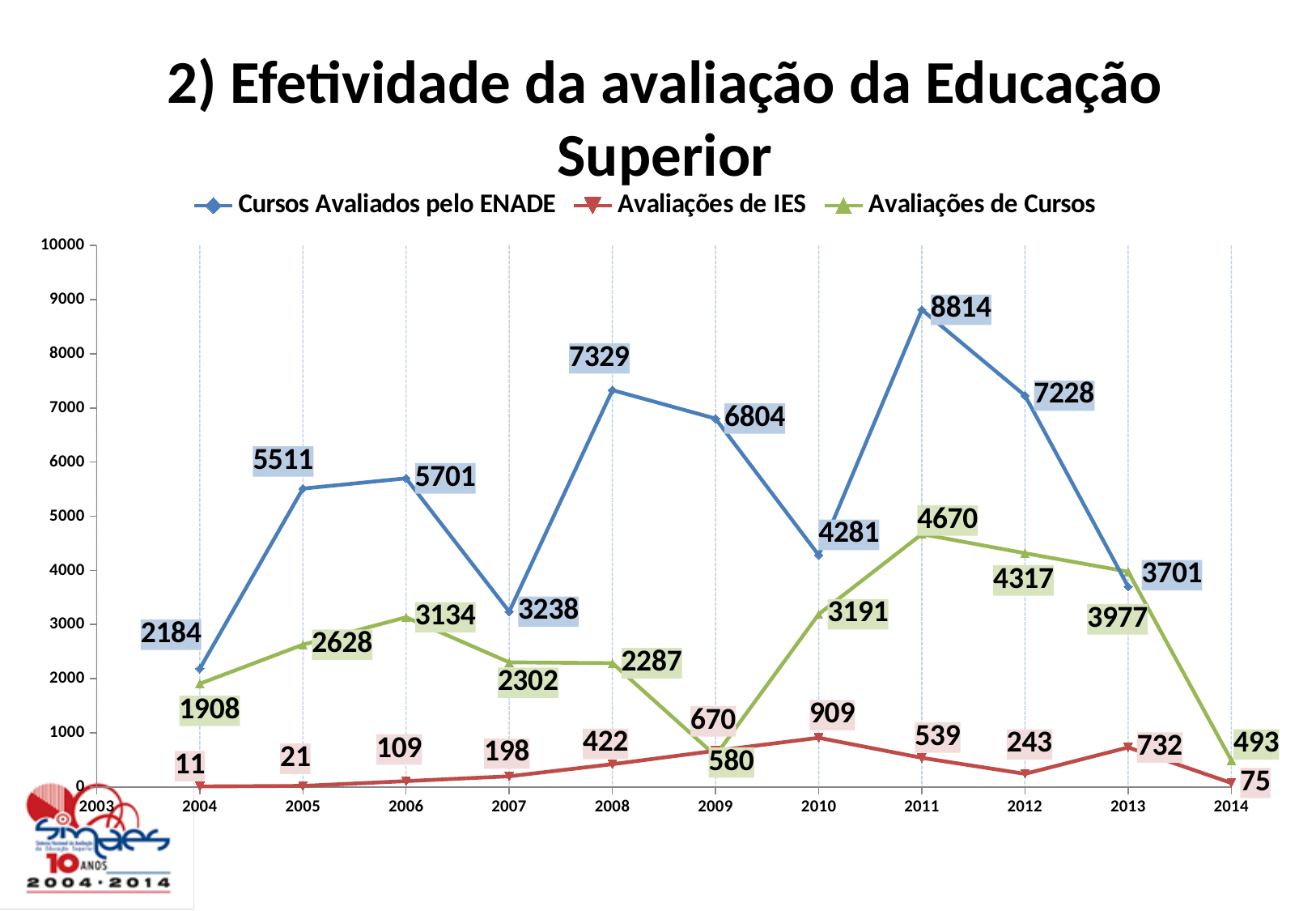
In which year is Avaliações de Cursos highest? 2011 Does Avaliações de Cursos rise or fall from 2013 to 2014? fall What is the value of Cursos Avaliados pelo ENADE in 2011? 8814 What is the value of Avaliações de IES in 2010? 909 In which year is Avaliações de IES lowest? 2004 What is the value of Avaliações de Cursos in 2014? 493 Which series is shown in green in the legend? Avaliações de Cursos Which is larger in 2013: Avaliações de Cursos or Cursos Avaliados pelo ENADE? Avaliações de Cursos What type of chart is shown on the slide? line chart What is the difference between Cursos Avaliados pelo ENADE in 2011 and in 2012? 1586 How many series does the legend list? 3 In which year is Cursos Avaliados pelo ENADE highest? 2011